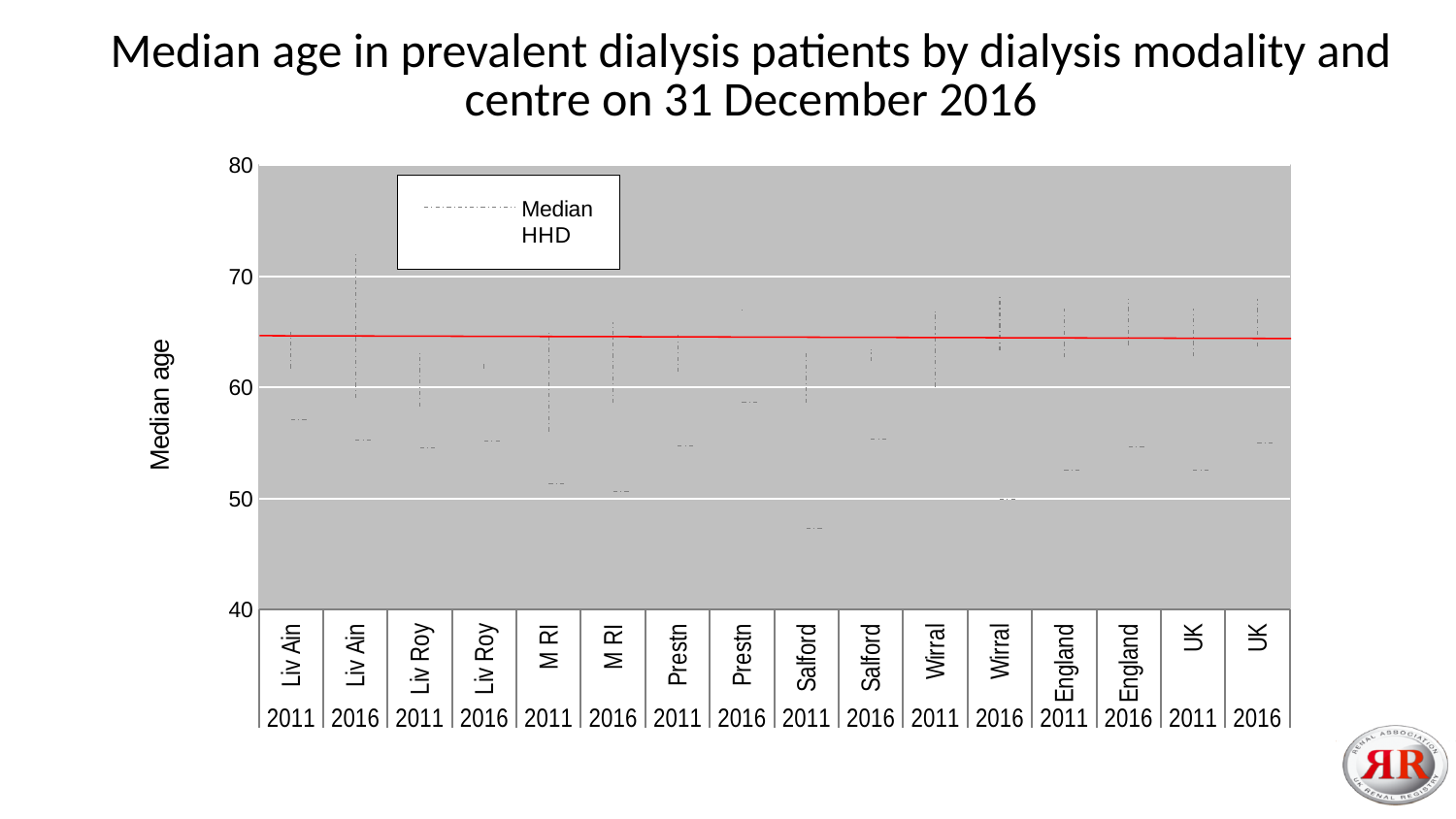
How many different years are shown for each centre on the x axis? 2 What is the title of the chart? Median age in prevalent dialysis patients by dialysis modality and centre on 31 December 2016 What series name is shown in the legend? Median HHD How many centre-year categories are shown along the x axis? 16 Is the Median HHD value for UK 2016 greater or less than 60? less Is the Median HHD value for Salford 2016 greater or less than 70? less Is the Median HHD value for Liv Ain 2011 greater or less than 70? less What kind of chart is shown on the slide? line chart How many series does the legend list? 1